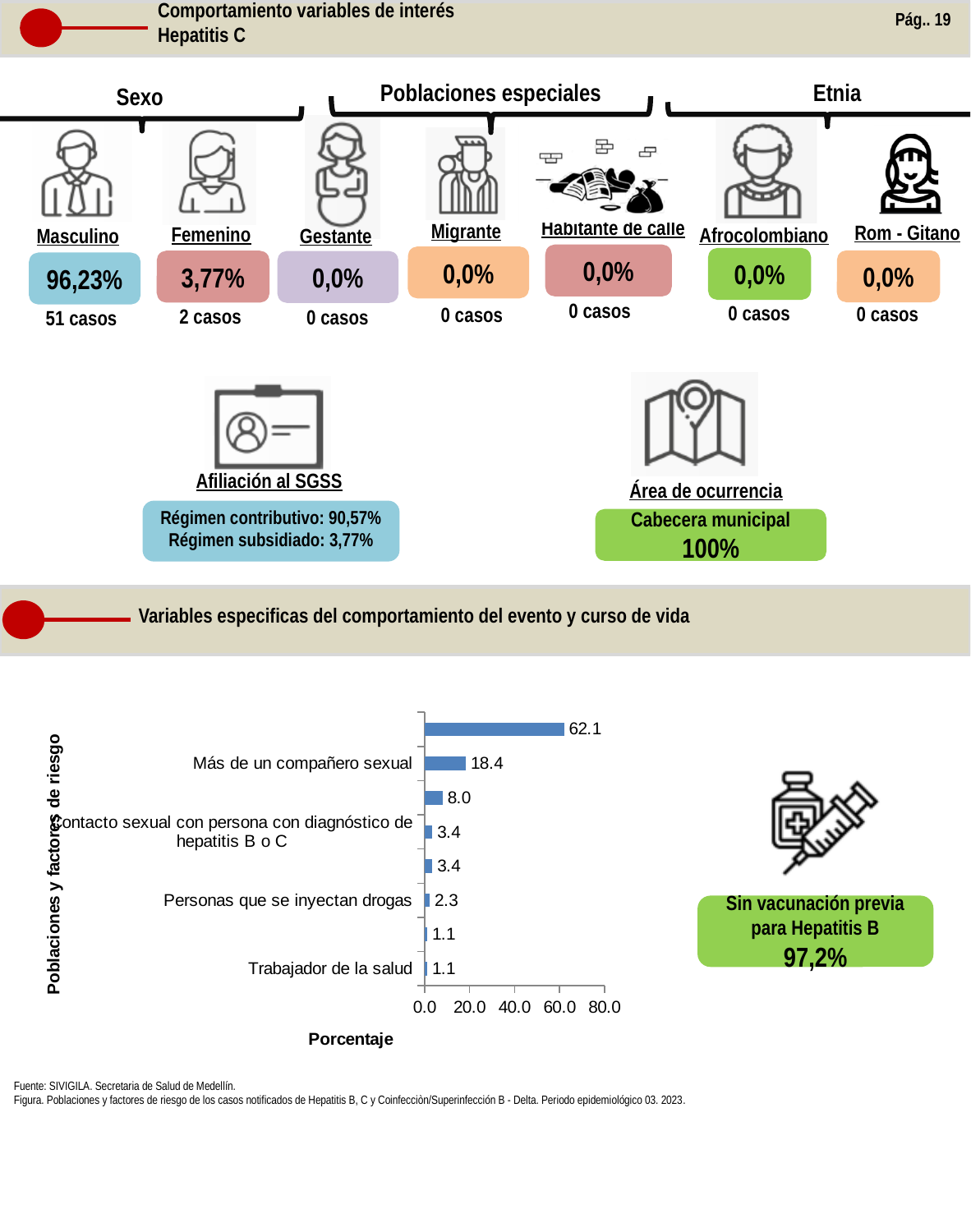
Which is larger in the bar chart: 'Más de un compañero sexual' or 'Personas que se inyectan drogas'? Más de un compañero sexual What is the value for 'Trabajador de la salud' in the bar chart? 1.1 Is the value for 'Más de un compañero sexual' greater or less than 20.0? less What is the difference between the values for 'Más de un compañero sexual' and 'Trabajador de la salud' in the bar chart? 17.3 What kind of chart is shown at the bottom of the slide? Bar chart What is the value for 'Contacto sexual con persona con diagnóstico de hepatitis B o C' in the bar chart? 3.4 What is the value for 'Más de un compañero sexual' in the bar chart? 18.4 What is the largest value shown in the bar chart? 62.1 How many bars are plotted in the bar chart? 8 What is the title of the horizontal axis of the bar chart? Porcentaje What is the value for 'Personas que se inyectan drogas' in the bar chart? 2.3 What is the smallest value shown in the bar chart? 1.1